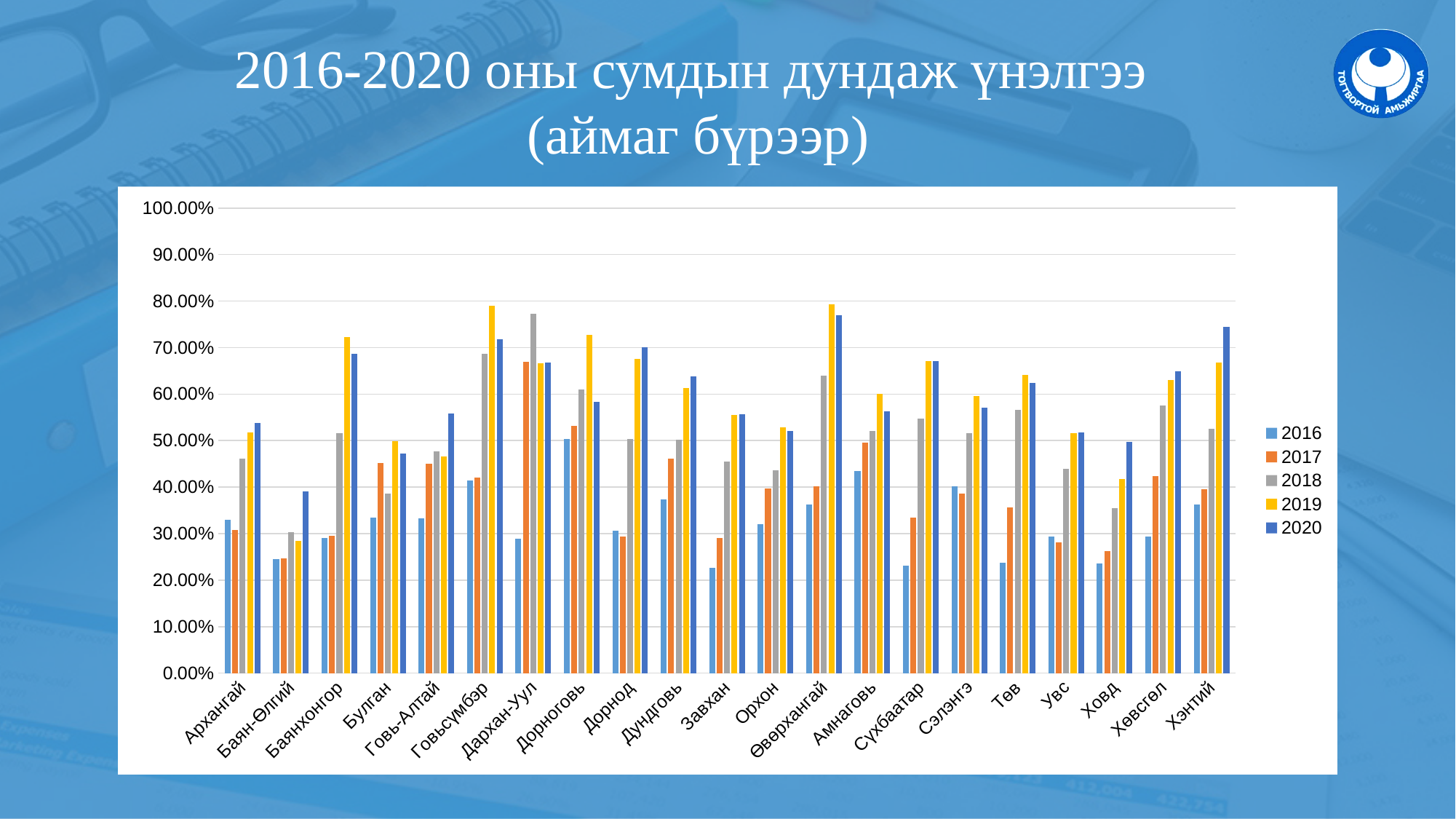
Do the values for Хэнтий rise or fall from 2016 to 2020? rise Is the 2016 value for Завхан greater or less than 30.00%? less Which year has the highest value for Говьсүмбэр? 2019 Is the 2019 value for Говьсүмбэр greater or less than 70.00%? greater Which is larger, the 2020 value for Архангай or the 2020 value for Баян-Өлгий? Архангай Which years are listed in the legend? 2016, 2017, 2018, 2019, 2020 What kind of chart is shown on the slide? bar chart Is the 2019 value for Баянхонгор greater or less than 70.00%? greater Which year has the highest value for Дархан-Уул? 2018 How many series does the legend list? 5 How many aimag categories are shown on the x axis? 21